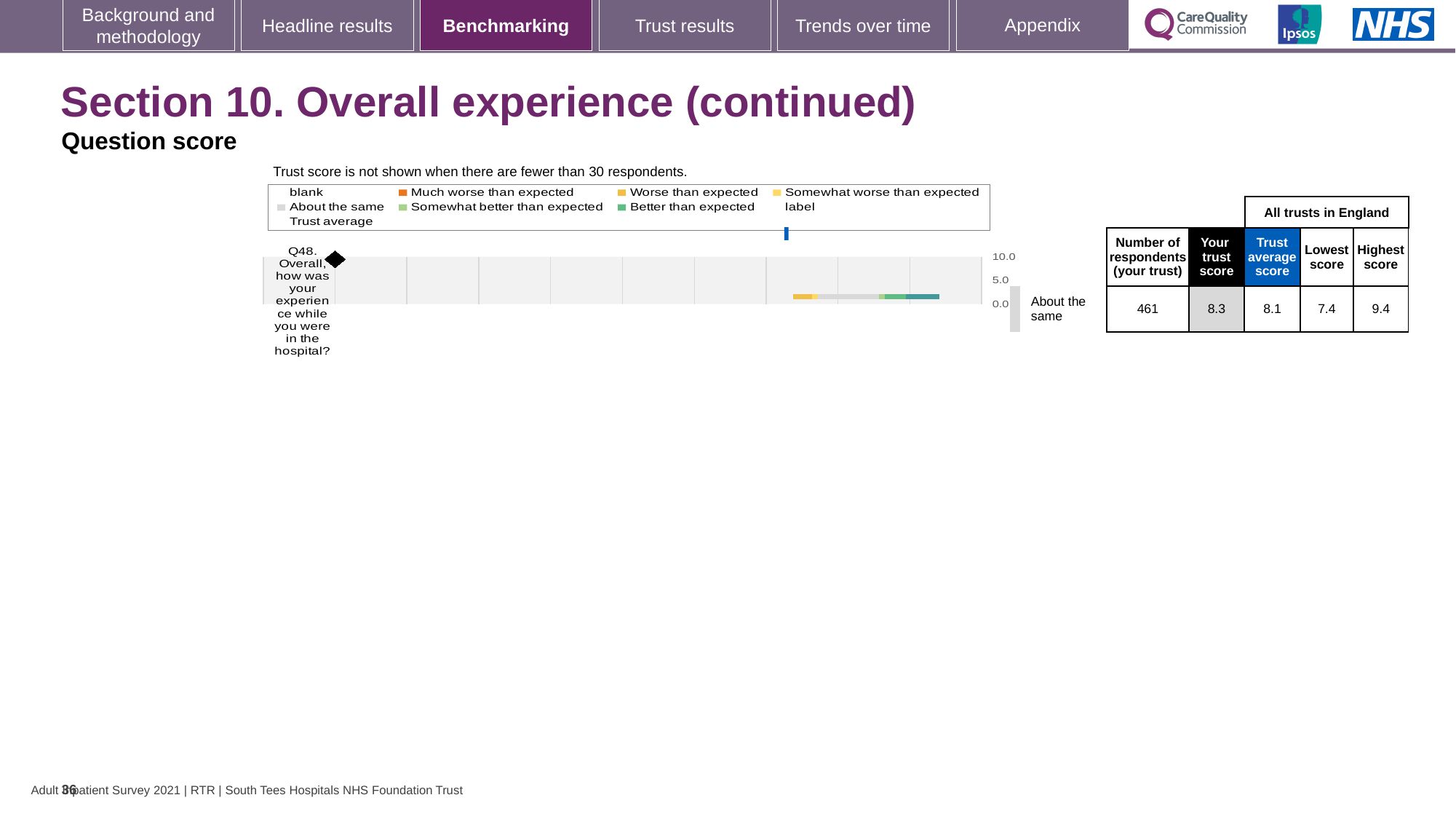
What is the highest score for Q48 among all trusts in England? 9.4 What is the lowest score for Q48 among all trusts in England? 7.4 What is the trust's score for Q48? 8.3 What kind of chart is shown on the slide? bar chart How many respondents answered Q48 for this trust? 461 What is the highest tick value shown on the chart's axis? 10.0 Which question is plotted in the chart? Q48. Overall, how was your experience while you were in the hospital? Which benchmark category is the trust's result for Q48 labelled as? About the same How many survey questions are plotted in the chart? 1 Which is larger for Q48, the trust's own score or the trust average score? the trust's own score What is the trust average score for Q48 across all trusts in England? 8.1 What is the difference between the highest and lowest scores for Q48 among all trusts in England? 2.0